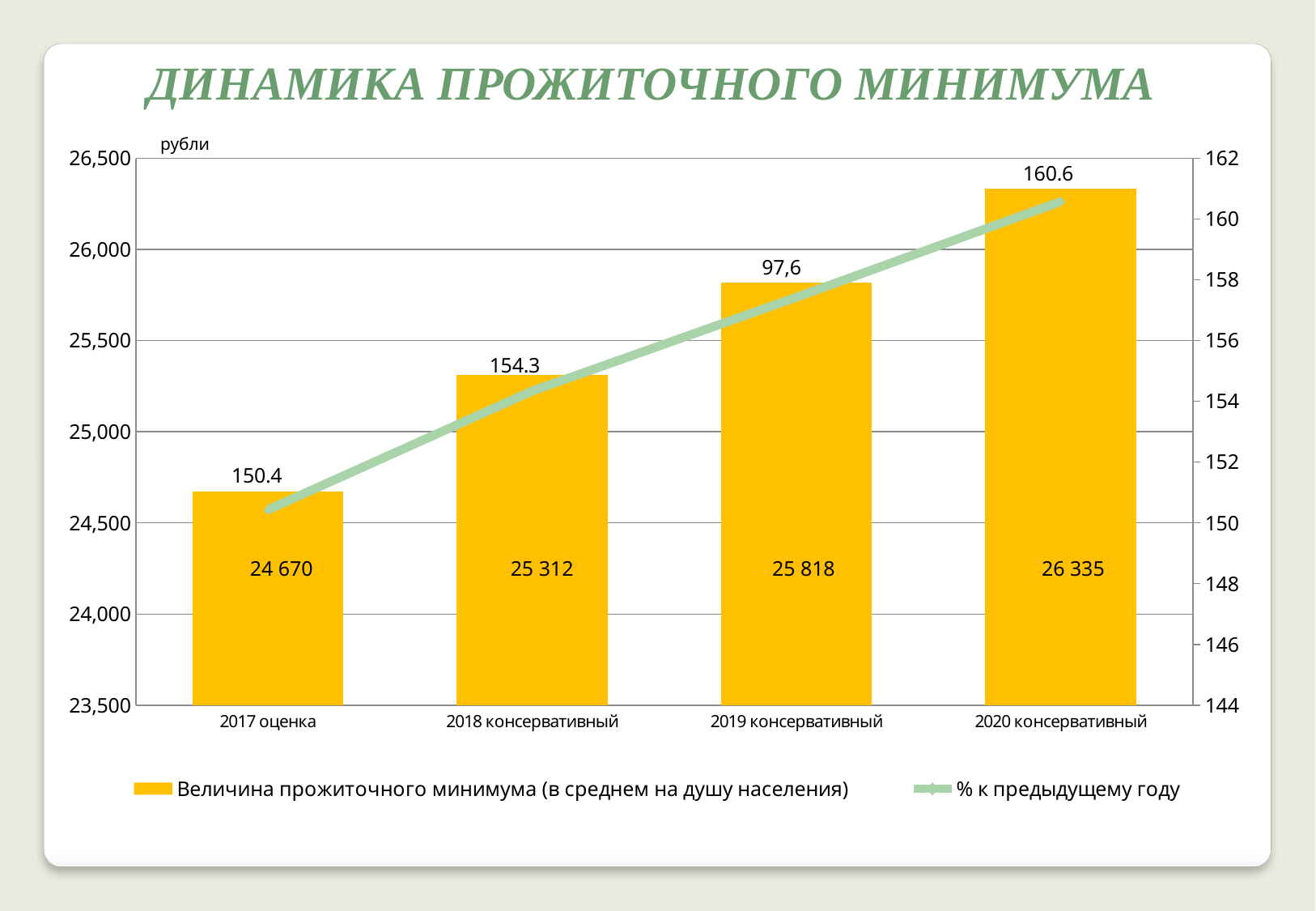
What is the value of the bar for 2017 оценка? 24 670 What is the '% к предыдущему году' value shown for 2020 консервативный? 160.6 Which is larger, the bar value for 2019 консервативный or for 2018 консервативный? 2019 консервативный What is the difference between the bar values for 2020 консервативный and 2019 консервативный? 517 What is the difference between the bar values for 2018 консервативный and 2017 оценка? 642 Which category has the lowest bar value? 2017 оценка What is the '% к предыдущему году' value shown for 2018 консервативный? 154.3 Which category has the highest bar value? 2020 консервативный What is the value of the bar for 2020 консервативный? 26 335 What is the value of the bar for 2019 консервативный? 25 818 How many series does the legend list? 2 How many categories are shown on the x axis? 4